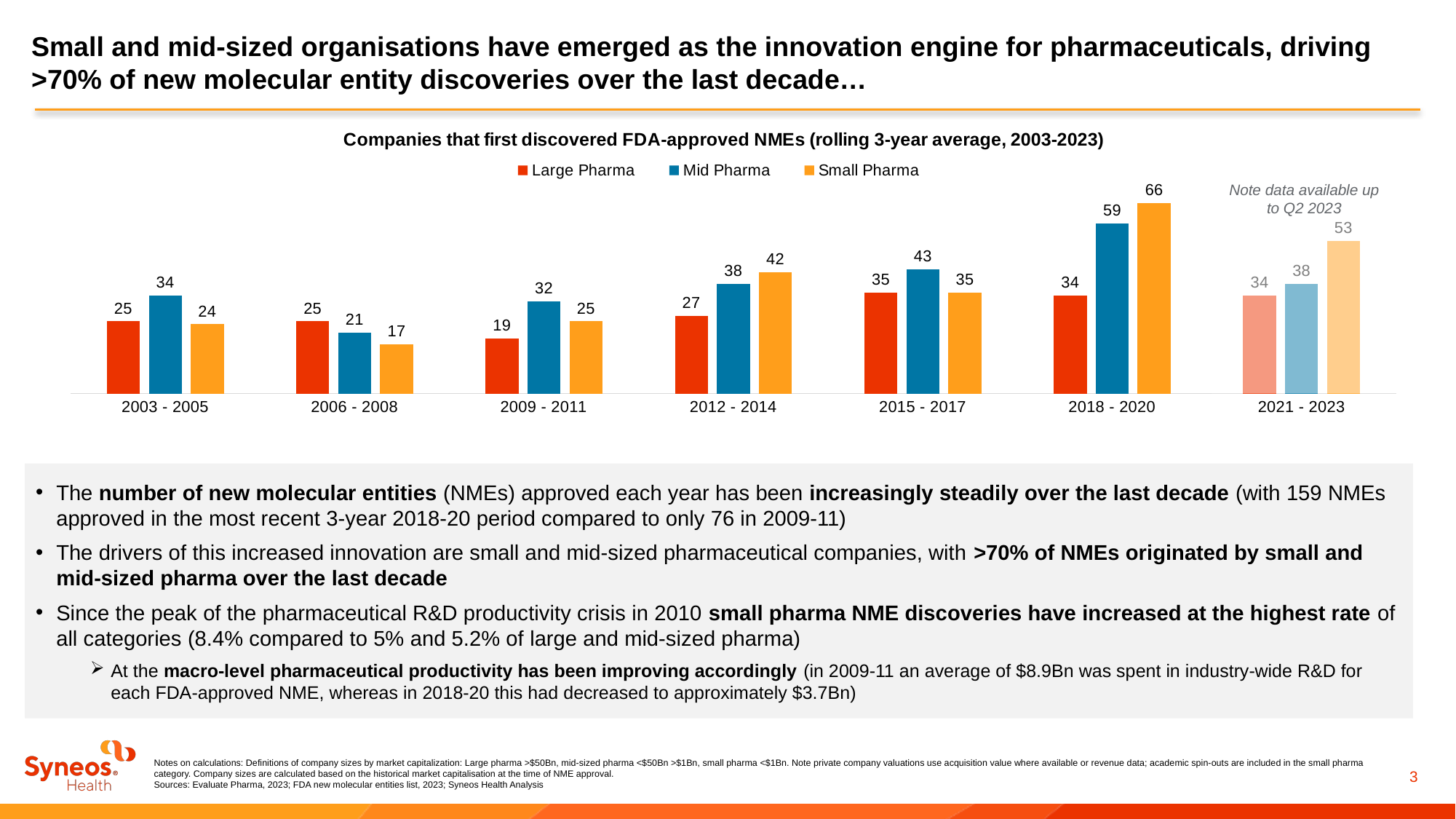
Which period has the highest value for Mid Pharma? 2018 - 2020 What is the title of the chart? Companies that first discovered FDA-approved NMEs (rolling 3-year average, 2003-2023) How many periods are shown on the x axis? 7 What kind of chart is shown on the slide? Bar chart Which period has the lowest value for Small Pharma? 2006 - 2008 What is the value for Small Pharma in 2018 - 2020? 66 In 2006 - 2008, which is larger: Large Pharma or Mid Pharma? Large Pharma Does the Small Pharma value rise or fall from 2009 - 2011 to 2018 - 2020? Rise What is the difference between the Small Pharma and Large Pharma values in 2018 - 2020? 32 What is the value for Mid Pharma in 2012 - 2014? 38 How many series does the legend list? 3 What is the value for Large Pharma in 2009 - 2011? 19